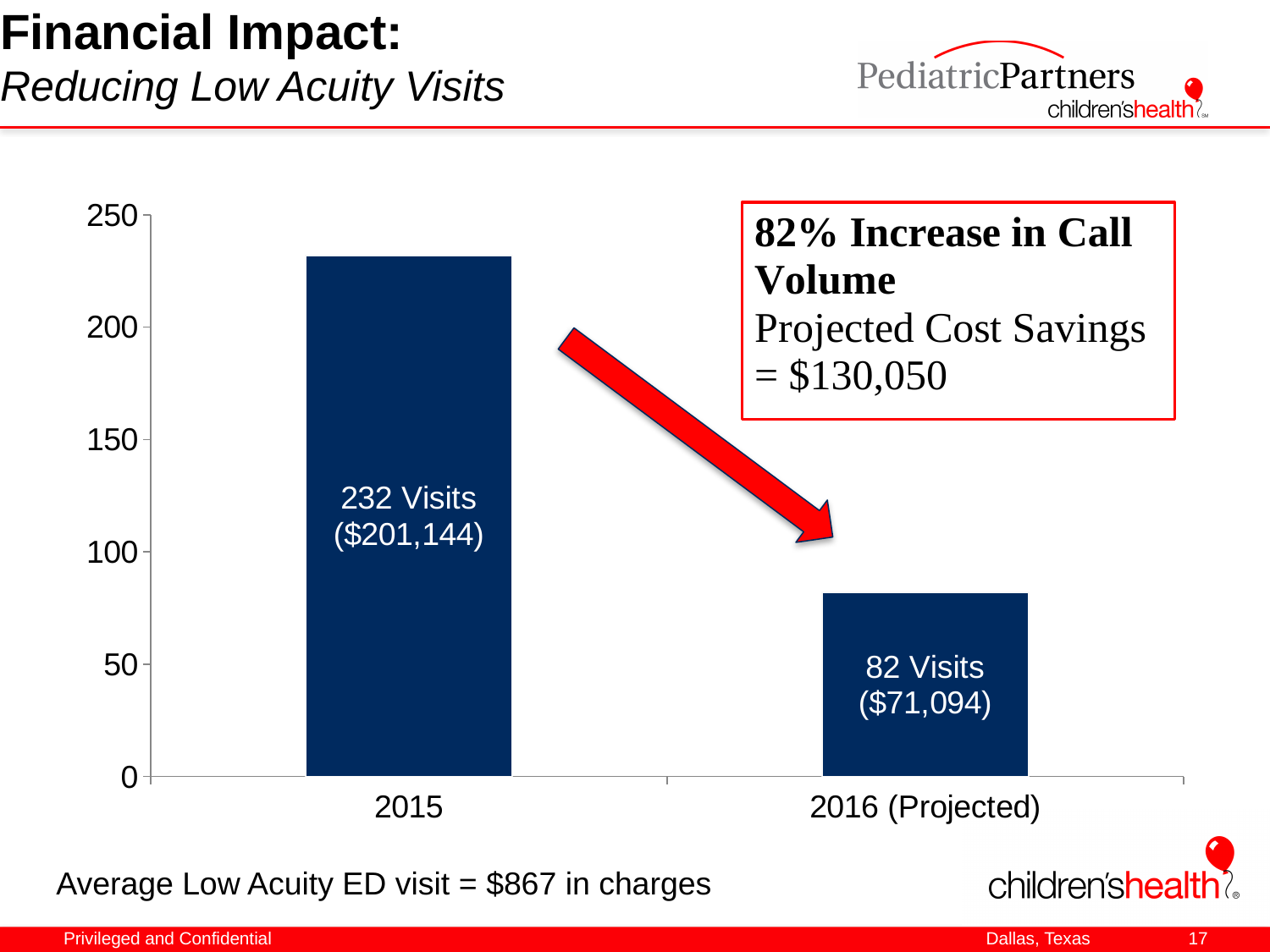
Which category has the higher number of visits? 2015 What dollar amount is labelled on the 2016 (Projected) bar? $71,094 How many categories are shown on the x axis? 2 Do the values rise or fall from 2015 to 2016 (Projected)? Fall How many visits does the chart show for 2016 (Projected)? 82 Visits What dollar amount is labelled on the 2015 bar? $201,144 What is the difference in visits between 2015 and 2016 (Projected)? 150 Is the number of visits for 2015 greater or less than 200? greater Which category has the lower number of visits? 2016 (Projected) What kind of chart is shown on the slide? Bar chart How many visits does the chart show for 2015? 232 Visits Is the number of visits for 2016 (Projected) greater or less than 100? less